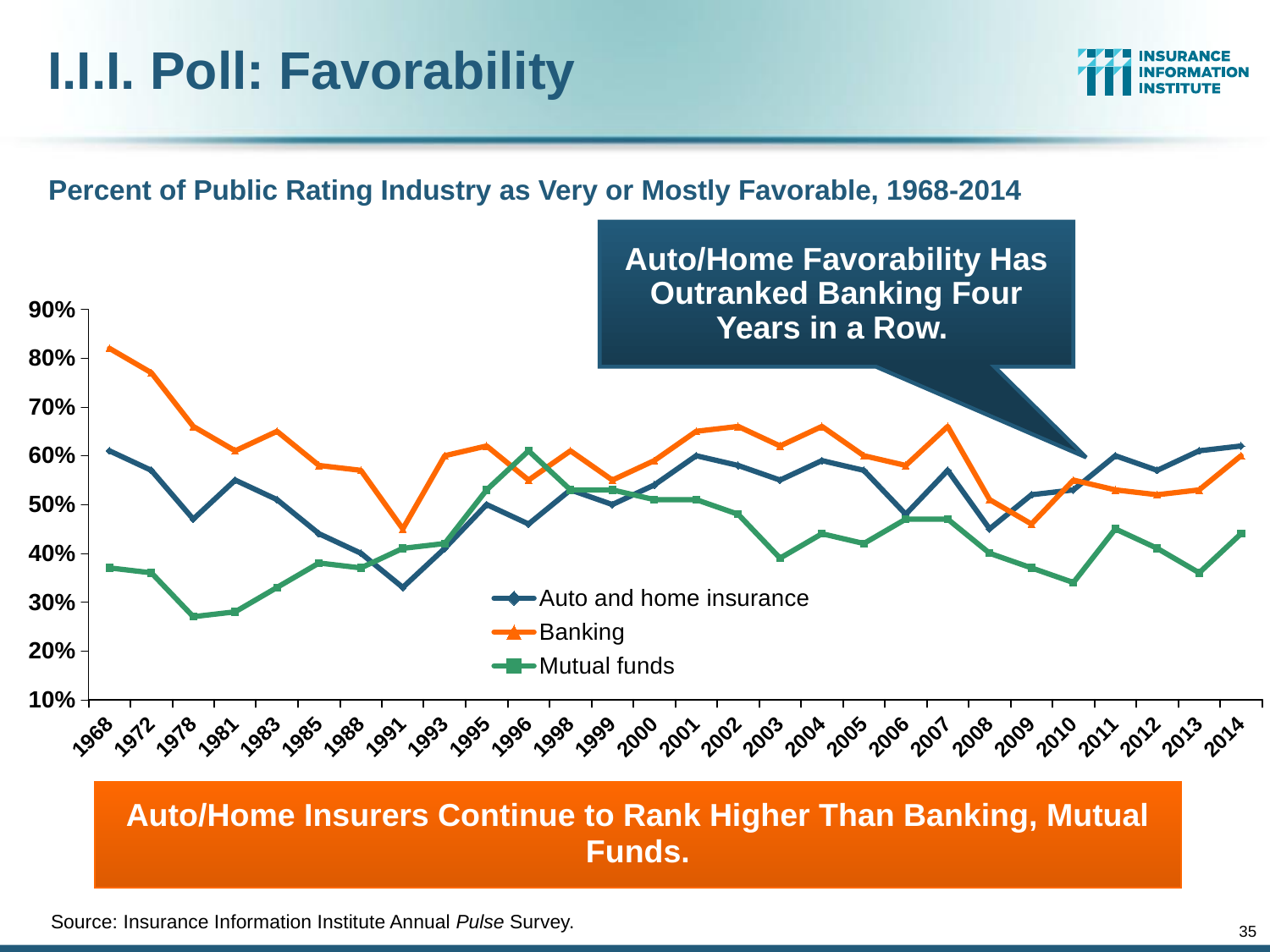
How many years are shown along the x axis? 28 In 2014, which is larger: Auto and home insurance or Mutual funds? Auto and home insurance Is the value for Auto and home insurance in 1991 greater or less than 40%? less How many series does the legend list? 3 Is the value for Mutual funds in 1978 greater or less than 30%? less In 1968, which is larger: Banking or Auto and home insurance? Banking Is the value for Banking in 1991 greater or less than 50%? less In which year is the Banking series at its highest? 1968 In which year is the Mutual funds series at its lowest? 1978 What kind of chart is shown on the slide? line chart Does the Banking series rise or fall from 1968 to 1978? fall